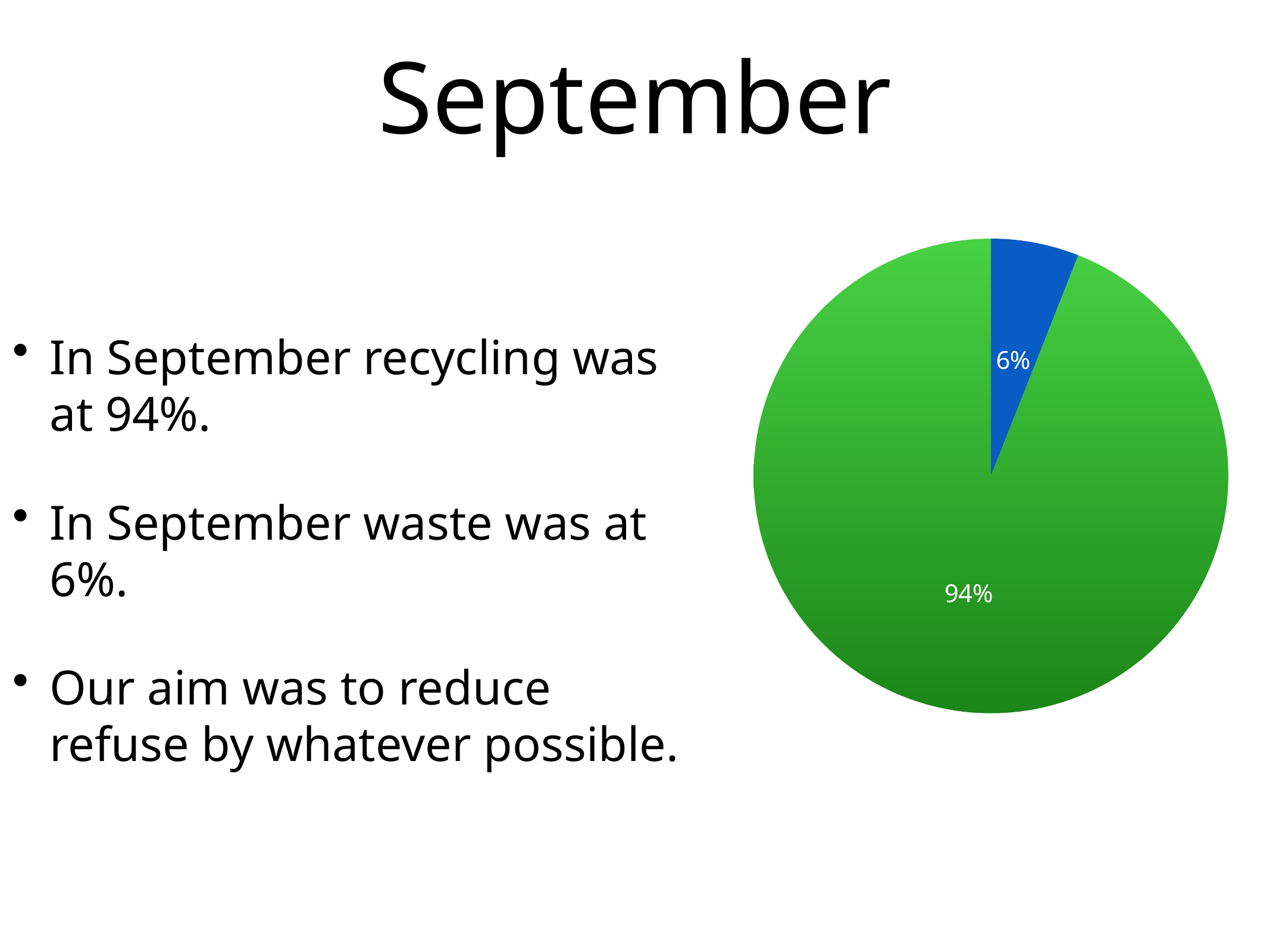
What share of the pie does the blue slice represent? 6% What colour is the slice labelled 6% in the pie chart? blue What share of the pie does the green slice represent? 94% What is the difference between the two slice values in the pie chart? 88% What kind of chart is shown on the slide? pie chart How many slices does the pie chart have? 2 Which slice of the pie chart is the largest? the green slice (94%) What percentage is shown on the blue slice of the pie chart? 6% What percentage is shown on the green slice of the pie chart? 94% What is the total of the two slice values shown in the pie chart? 100% Which is larger in the pie chart, the green slice or the blue slice? the green slice Which slice of the pie chart is the smallest? the blue slice (6%)